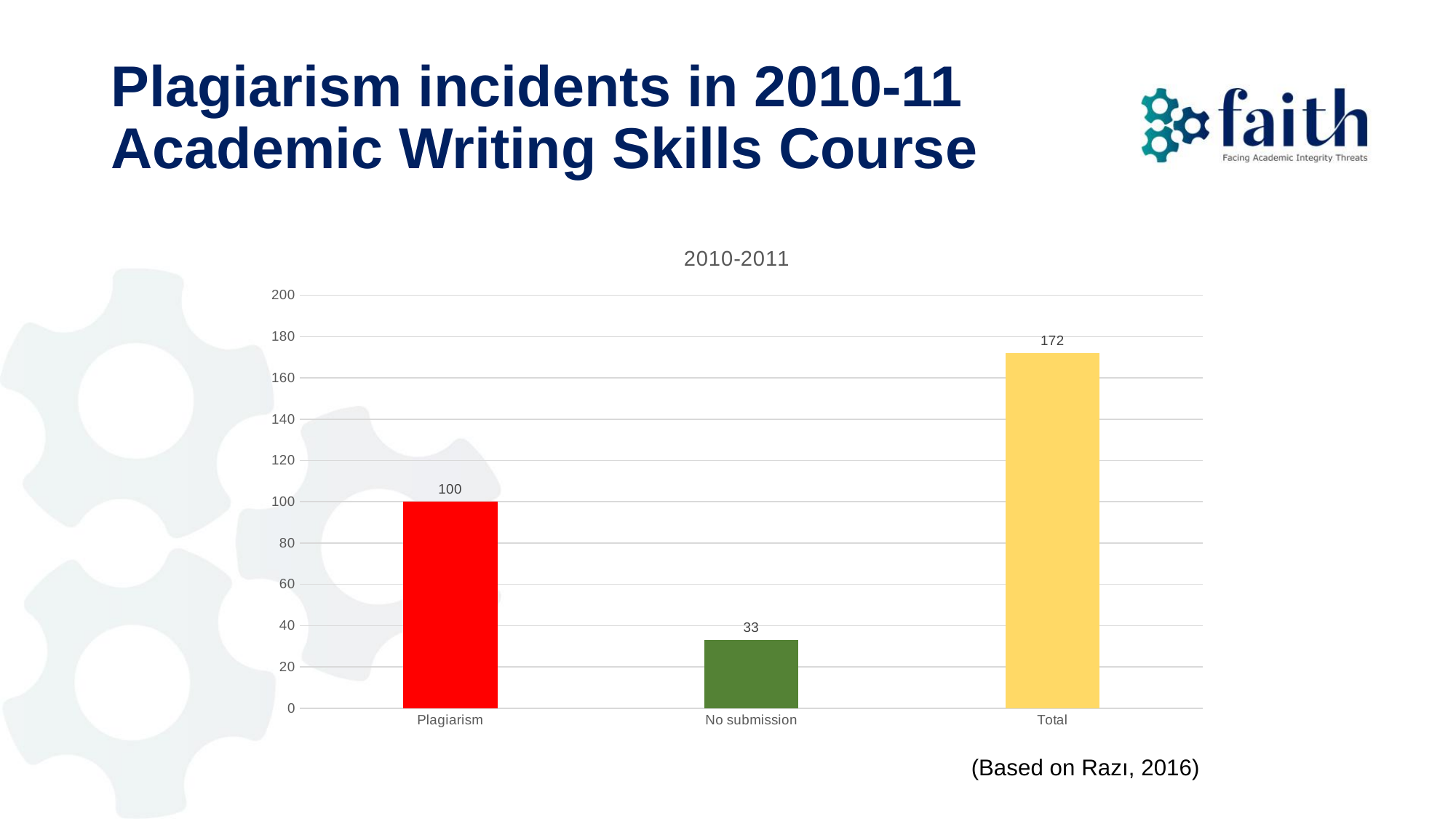
Which category has the highest value? Total Is the value for Total greater or less than 160? greater What is the value for Plagiarism? 100 How many categories are shown on the x axis? 3 What is the difference between the values for Plagiarism and No submission? 67 What is the value for No submission? 33 What is the title of the chart? 2010-2011 Which category has the lowest value? No submission What kind of chart is shown on the slide? bar chart What is the value for Total? 172 What is the difference between the values for Total and Plagiarism? 72 Which is larger, the value for Plagiarism or the value for No submission? Plagiarism